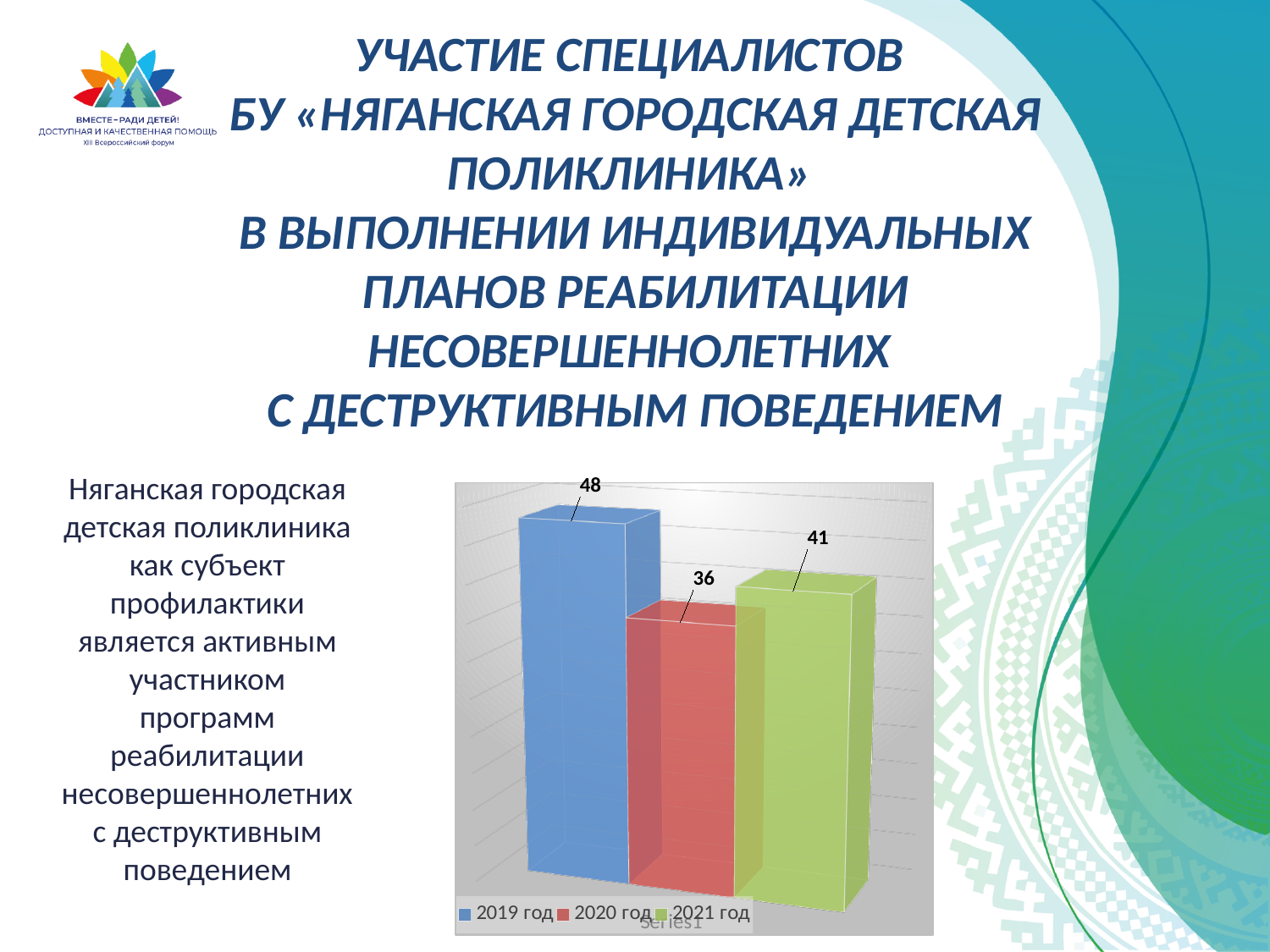
What is the value for 2021 год? 41 Which is larger, the value for 2021 год or the value for 2020 год? 2021 год Which year has the lowest value? 2020 год What is the value for 2019 год? 48 What kind of chart is shown on the slide? Bar chart How many bars are plotted in the chart? 3 Which year has the highest value? 2019 год What is the difference between the values for 2019 год and 2020 год? 12 How many series does the legend list? 3 What colour is the bar for 2020 год? Red What is the difference between the values for 2021 год and 2020 год? 5 What is the value for 2020 год? 36